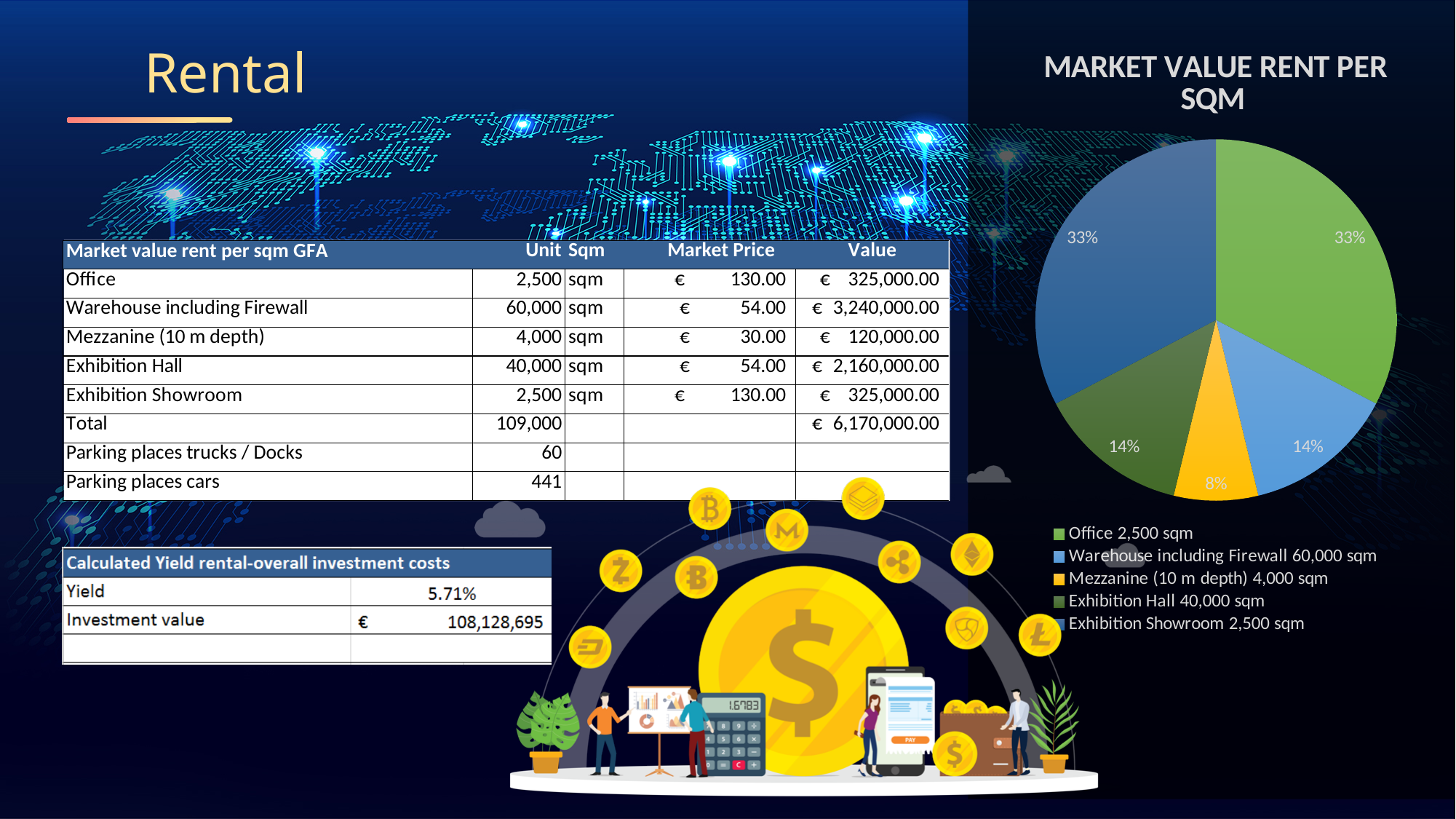
What share of the pie chart does Office 2,500 sqm represent? 33% Which slice is larger in the pie chart, Office 2,500 sqm or Mezzanine (10 m depth) 4,000 sqm? Office 2,500 sqm What share of the pie chart does Warehouse including Firewall 60,000 sqm represent? 14% Which legend entry in the pie chart is shown in orange? Mezzanine (10 m depth) 4,000 sqm What is the title of the pie chart? MARKET VALUE RENT PER SQM What kind of chart is shown on the slide? pie chart What share of the pie chart does Mezzanine (10 m depth) 4,000 sqm represent? 8% How many slices does the pie chart have? 5 Which slice of the pie chart is the smallest? Mezzanine (10 m depth) 4,000 sqm What is the difference in percentage points between the Office 2,500 sqm slice and the Mezzanine (10 m depth) 4,000 sqm slice? 25%